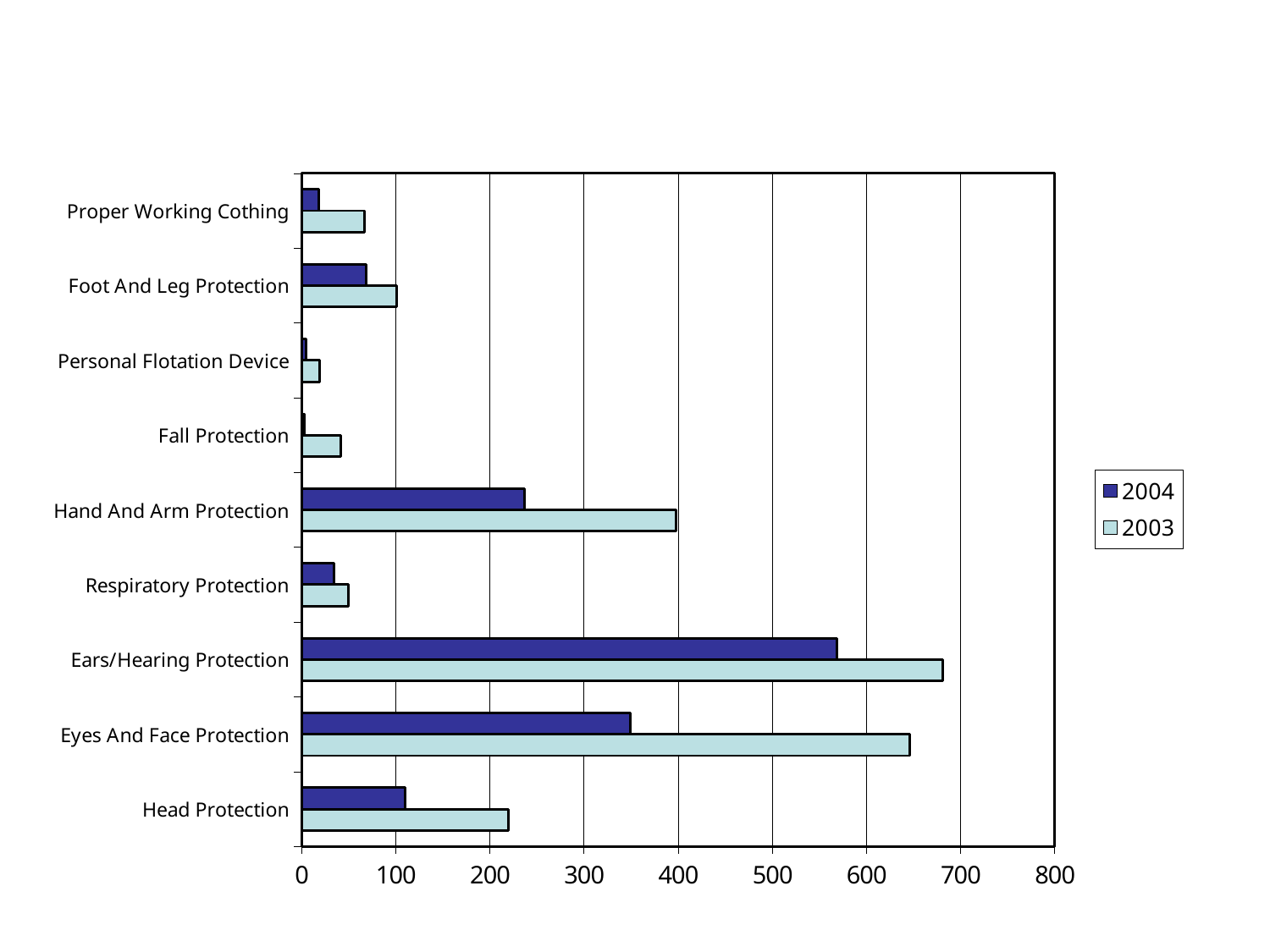
What are the two entries listed in the legend? 2004 and 2003 Which category has the highest value for 2004? Ears/Hearing Protection For Eyes And Face Protection, which year has the larger value, 2003 or 2004? 2003 Is the 2003 value for Head Protection greater or less than 300? less Is the 2004 value for Ears/Hearing Protection greater or less than 500? greater Which has the larger 2003 value, Hand And Arm Protection or Head Protection? Hand And Arm Protection How many series does the legend list? 2 What kind of chart is shown on the slide? bar chart How many categories are shown on the vertical axis? 9 Is the 2004 value for Hand And Arm Protection greater or less than 300? less Which category has the highest value for 2003? Ears/Hearing Protection